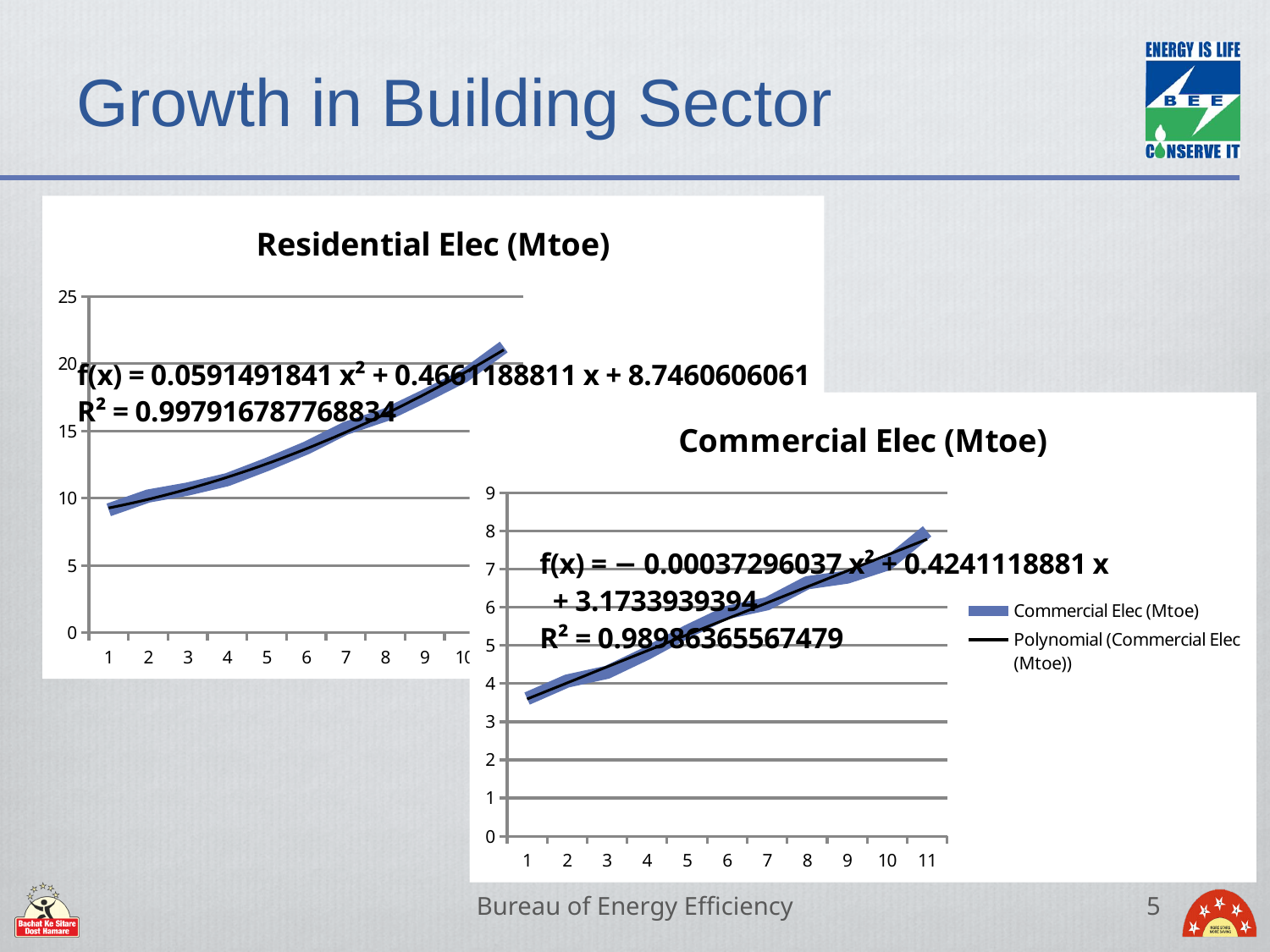
In the Commercial Elec (Mtoe) chart, is the value at x = 11 greater or less than 7? greater In the Residential Elec (Mtoe) chart, is the value at x = 1 greater or less than 10? less How many entries does the legend of the Commercial Elec (Mtoe) chart list? 2 What kind of chart is the Commercial Elec (Mtoe) chart? line chart In the Commercial Elec (Mtoe) chart, at which x value is the plotted value lowest? 1 In the Commercial Elec (Mtoe) chart, is the value at x = 1 greater or less than 4? less How many points are plotted in the Commercial Elec (Mtoe) chart? 11 What is the R² value shown on the Commercial Elec (Mtoe) chart? 0.98986365567479 What kind of chart is the Residential Elec (Mtoe) chart? line chart In the Residential Elec (Mtoe) chart, do the values rise or fall along the x axis? rise In the Commercial Elec (Mtoe) chart, do the values rise or fall along the x axis? rise